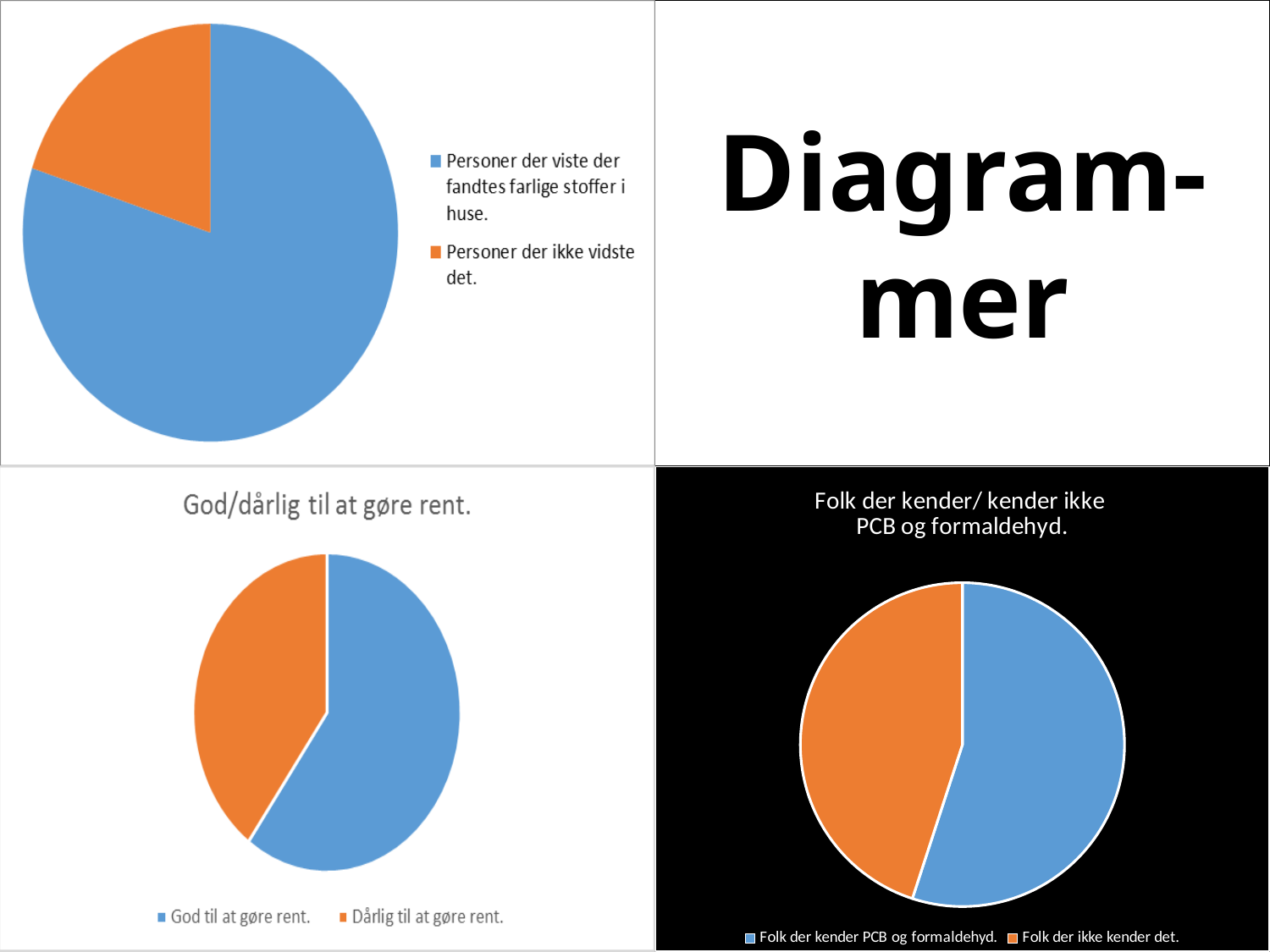
In the top-left pie chart, which category has the smallest slice? Personer der ikke vidste det. What is the title of the bottom-left chart on the slide? God/dårlig til at gøre rent. In the chart titled 'Folk der kender/ kender ikke PCB og formaldehyd.', what colour is the slice for 'Folk der ikke kender det.'? orange What kind of chart is the top-left chart on the slide? pie chart In the chart titled 'Folk der kender/ kender ikke PCB og formaldehyd.', which category has the largest slice? Folk der kender PCB og formaldehyd. What kind of chart is the chart titled 'God/dårlig til at gøre rent.'? pie chart What kind of chart is the chart titled 'Folk der kender/ kender ikke PCB og formaldehyd.'? pie chart In the chart titled 'God/dårlig til at gøre rent.', which slice is larger: 'God til at gøre rent.' or 'Dårlig til at gøre rent.'? God til at gøre rent. How many slices does the top-left pie chart have? 2 In the top-left pie chart, which category has the largest slice? Personer der viste der fandtes farlige stoffer i huse. How many categories does the legend of the chart titled 'God/dårlig til at gøre rent.' list? 2 How many slices does the chart titled 'Folk der kender/ kender ikke PCB og formaldehyd.' have? 2